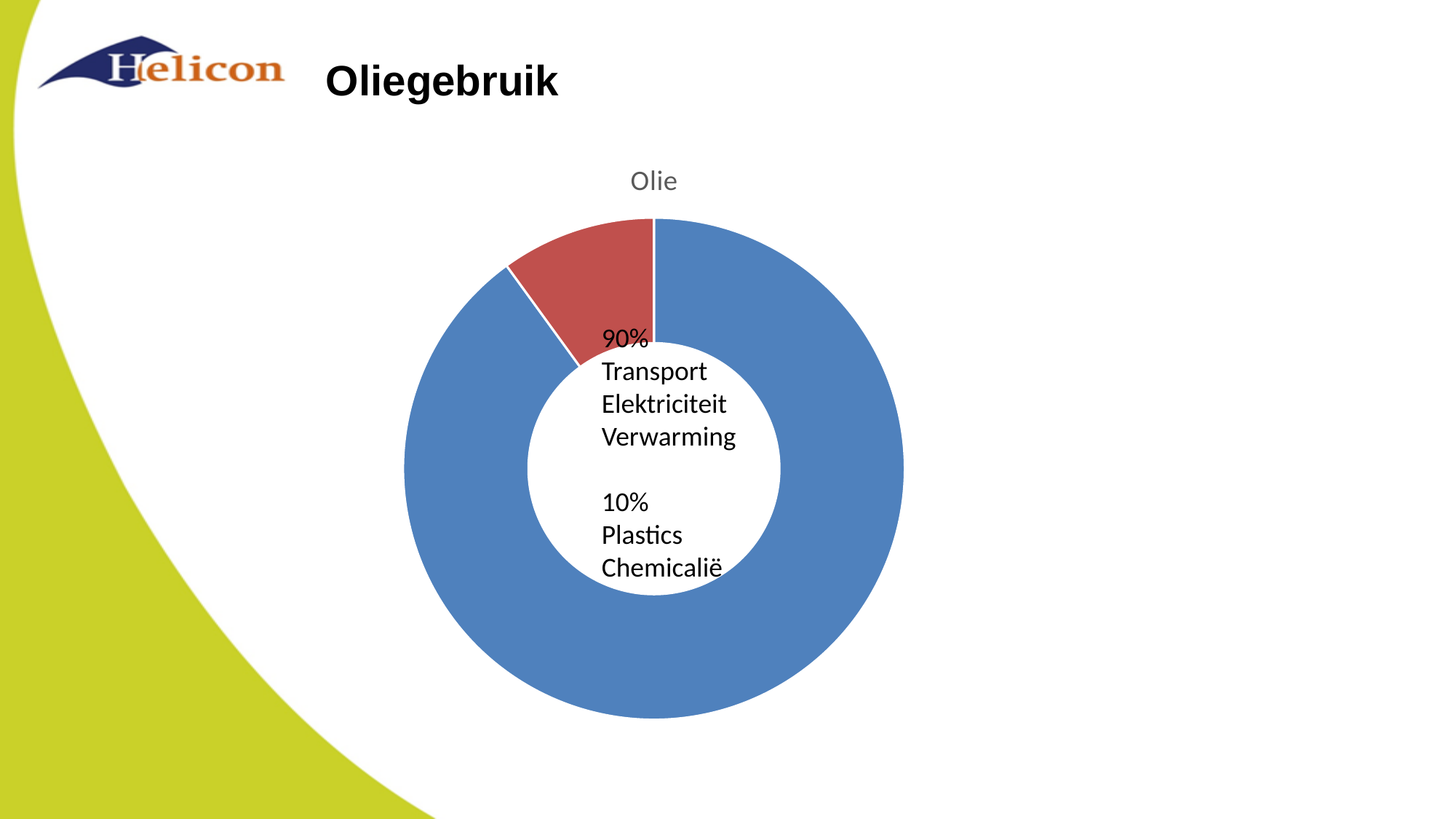
What share of oil use is attributed to Plastics and Chemicaliën? 10% Which slice is the smallest? Plastics, Chemicaliën (10%) What is the difference in percentage points between the 90% slice and the 10% slice? 80 percentage points Which slice is the largest? Transport, Elektriciteit, Verwarming (90%) How many slices does the chart have? 2 Which is larger: the share for Transport/Elektriciteit/Verwarming or the share for Plastics/Chemicaliën? Transport/Elektriciteit/Verwarming What is the title of the chart? Olie Is the share for Plastics and Chemicaliën greater or less than 50%? less What share of oil use is attributed to Transport, Elektriciteit and Verwarming? 90% What colour is the slice representing Plastics and Chemicaliën? Red What kind of chart is shown on the slide? Doughnut (pie) chart